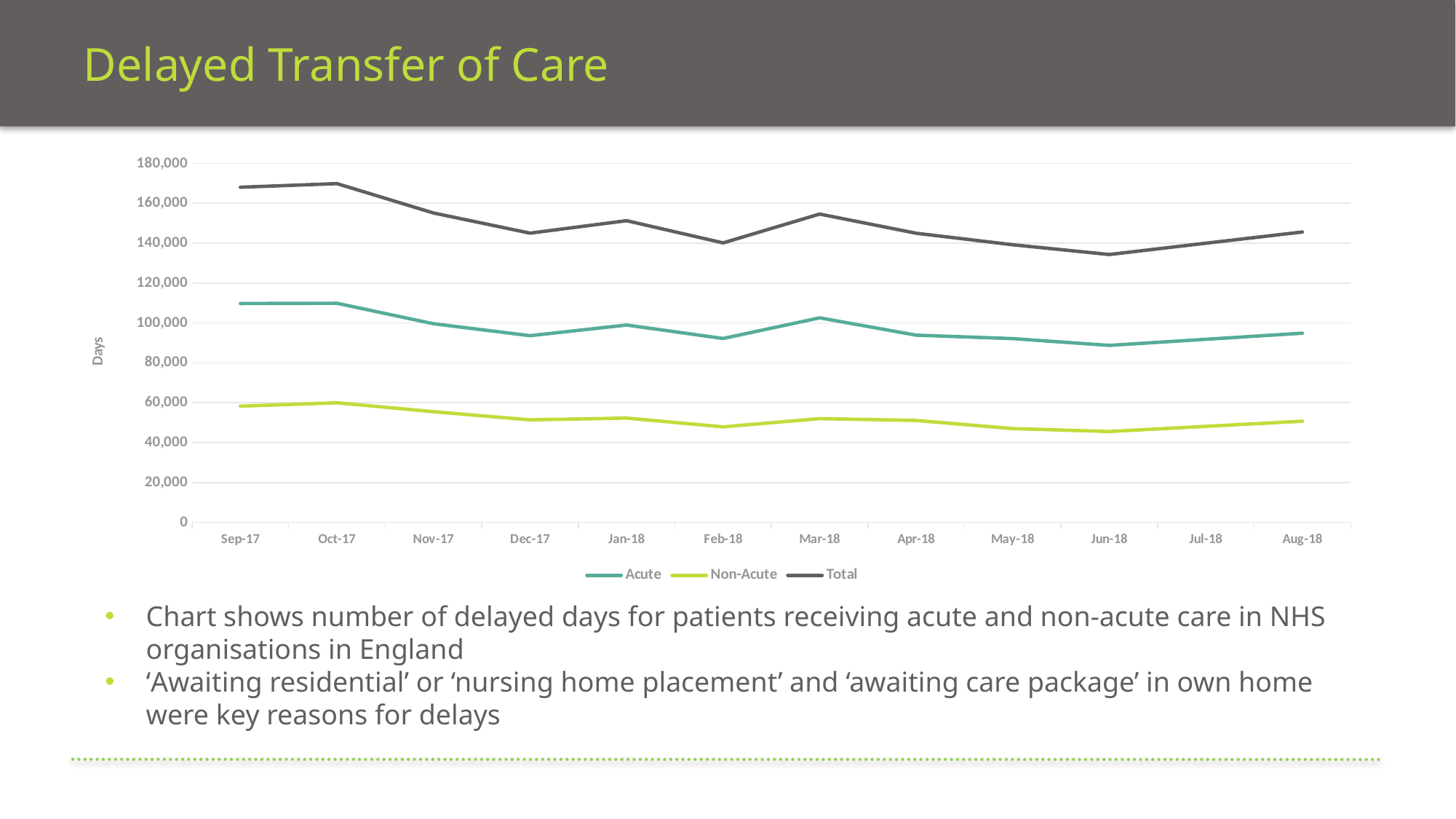
Which is larger, the Total value for Oct-17 or for Jun-18? Oct-17 In which month is the Total series at its lowest? Jun-18 What is the label on the y axis? Days How many series does the legend list? 3 Is the Total value for Sep-17 greater or less than 160,000? greater Is the Acute value for Mar-18 greater or less than 100,000? greater Does the Acute series rise or fall from Oct-17 to Dec-17? Fall In which month is the Non-Acute series at its lowest? Jun-18 What kind of chart is shown on the slide? Line chart Is the Non-Acute value for Jun-18 greater or less than 50,000? less How many months are plotted along the x axis? 12